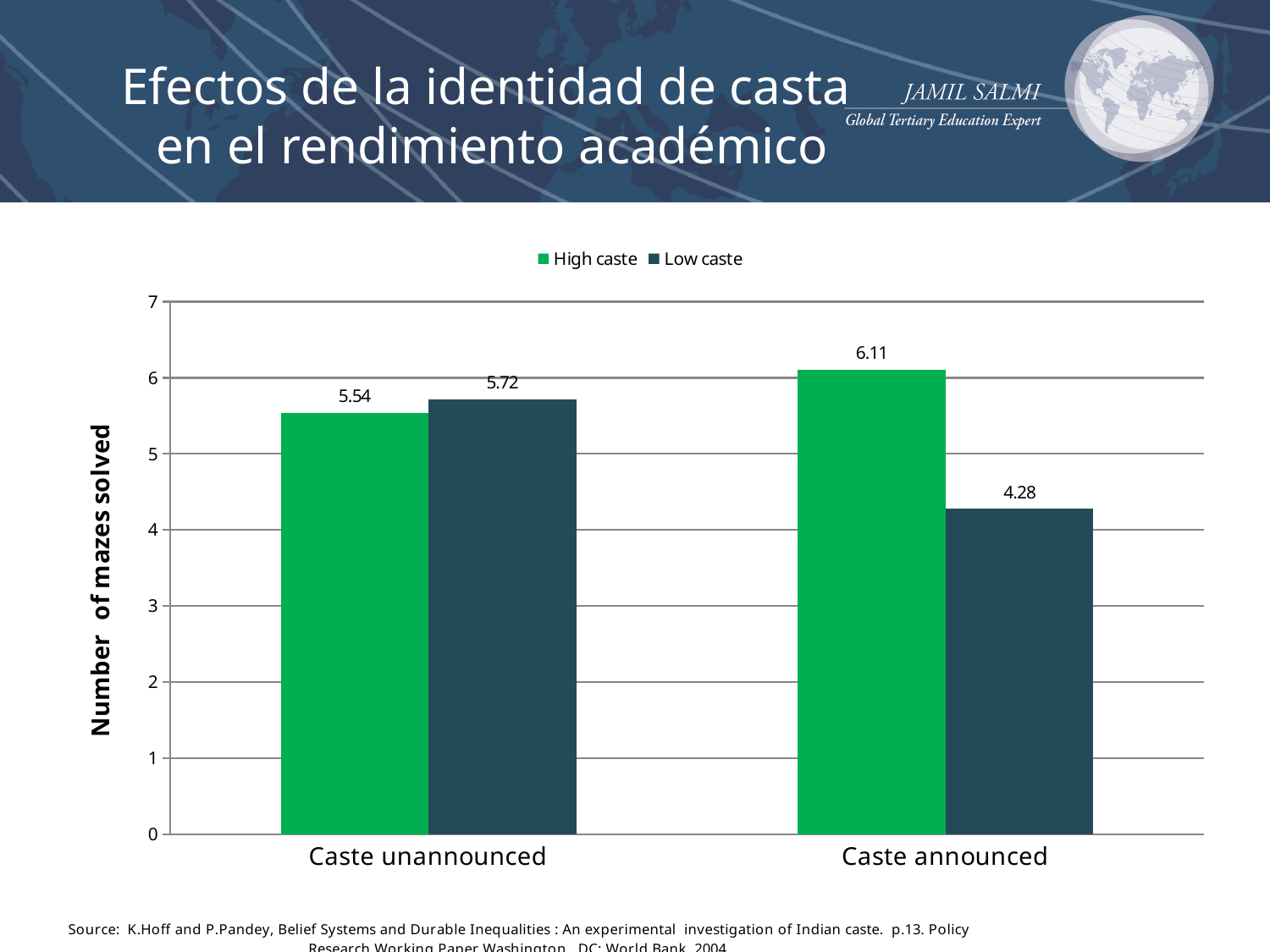
What is the value for High caste when caste is announced? 6.11 What is the difference between High caste and Low caste when caste is announced? 1.83 Which is larger in the Caste unannounced condition, High caste or Low caste? Low caste What is the value for Low caste when caste is unannounced? 5.72 Which bar has the highest value on the chart? High caste, Caste announced How many series does the legend list? 2 What is the value for Low caste when caste is announced? 4.28 What is the value for High caste when caste is unannounced? 5.54 How many categories are shown on the x axis? 2 What is the label of the y axis? Number of mazes solved What kind of chart is shown on the slide? Bar chart Which bar has the lowest value on the chart? Low caste, Caste announced